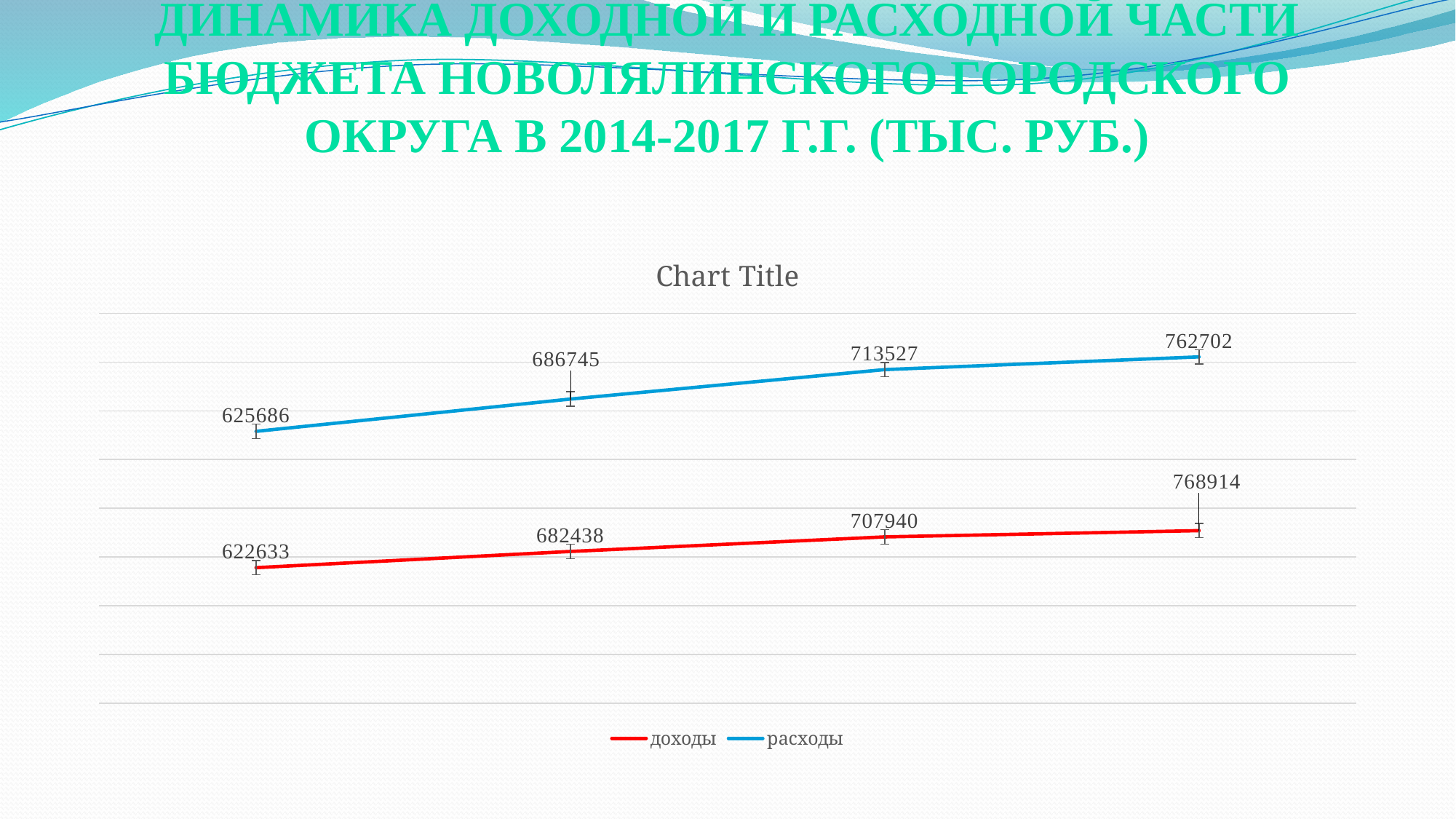
What is the difference between the last and first values on the доходы line? 146281 Do the values on the расходы line rise or fall from left to right? rise What is the lowest value on the расходы line? 625686 What is the value of the third data point on the доходы line? 707940 What is the highest value on the доходы line? 768914 At the last data point, which series has the larger value, доходы or расходы? доходы What is the value of the first data point on the доходы line? 622633 What is the value of the last data point on the расходы line? 762702 What kind of chart is shown on the slide? line chart How many data points does the доходы line have? 4 What colour is the расходы line in the legend? blue How many series does the legend list? 2